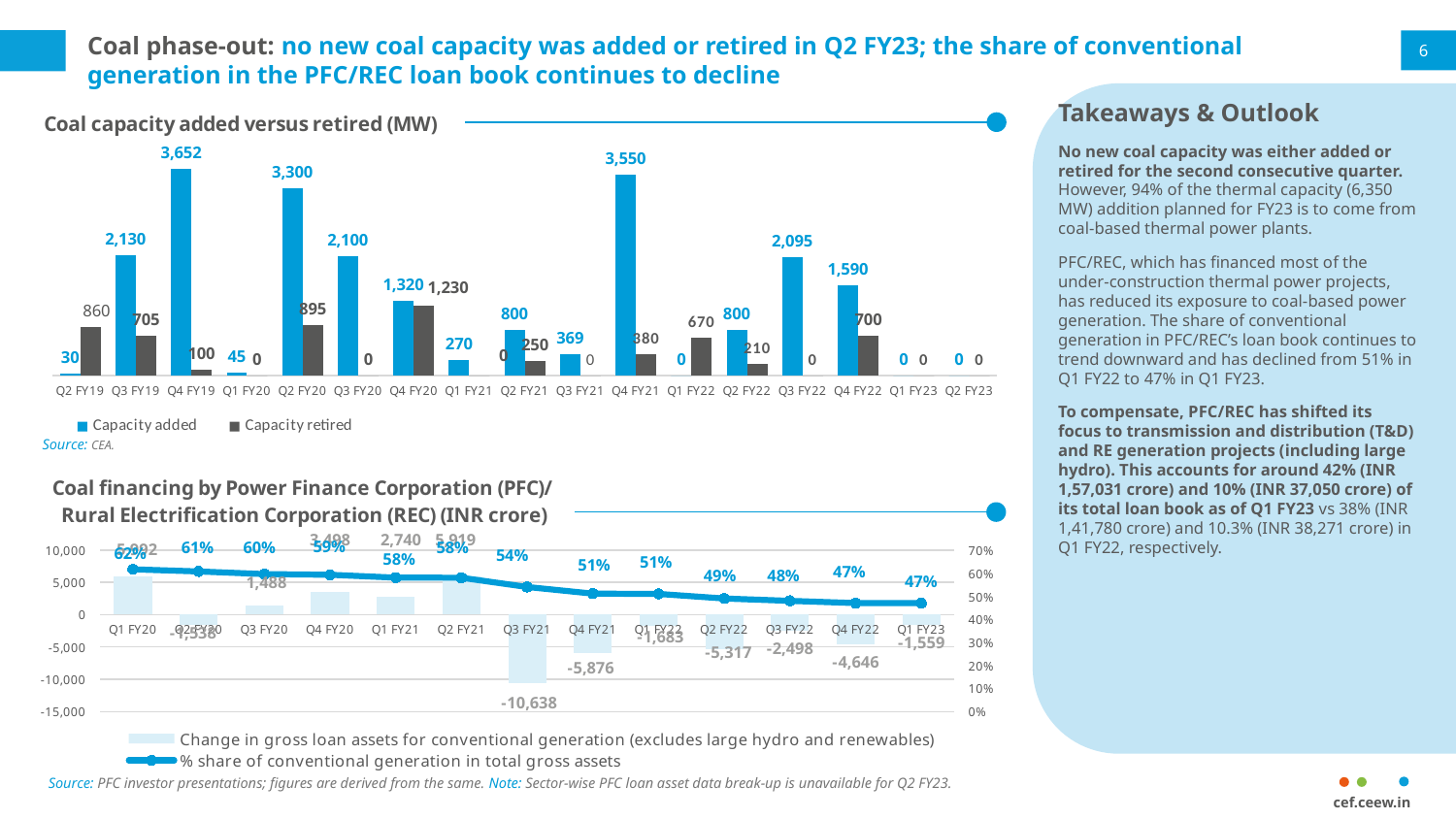
In the 'Coal capacity added versus retired (MW)' chart, which was larger in Q2 FY19: capacity added or capacity retired? Capacity retired In the 'Coal financing by PFC/REC' chart, what was the change in gross loan assets for conventional generation in Q3 FY21? -10,638 In the 'Coal capacity added versus retired (MW)' chart, what was the capacity added in Q4 FY19? 3,652 In the 'Coal financing by PFC/REC' chart, what is the difference between the % share in Q1 FY20 and Q1 FY23? 15 percentage points In the 'Coal capacity added versus retired (MW)' chart, what was the capacity retired in Q4 FY20? 1,230 How many series does the legend of the 'Coal capacity added versus retired (MW)' chart list? 2 In the 'Coal financing by PFC/REC' chart, does the % share of conventional generation in total gross assets rise or fall from Q1 FY20 to Q1 FY23? Fall In the 'Coal capacity added versus retired (MW)' chart, what is the difference between capacity added and capacity retired in Q2 FY20? 2,405 In the 'Coal financing by PFC/REC' chart, what was the % share of conventional generation in total gross assets in Q1 FY23? 47% What kind of chart is the 'Coal capacity added versus retired (MW)' chart? Bar chart In the 'Coal capacity added versus retired (MW)' chart, which quarter had the highest capacity added? Q4 FY19 How many quarters are shown on the x axis of the 'Coal capacity added versus retired (MW)' chart? 17